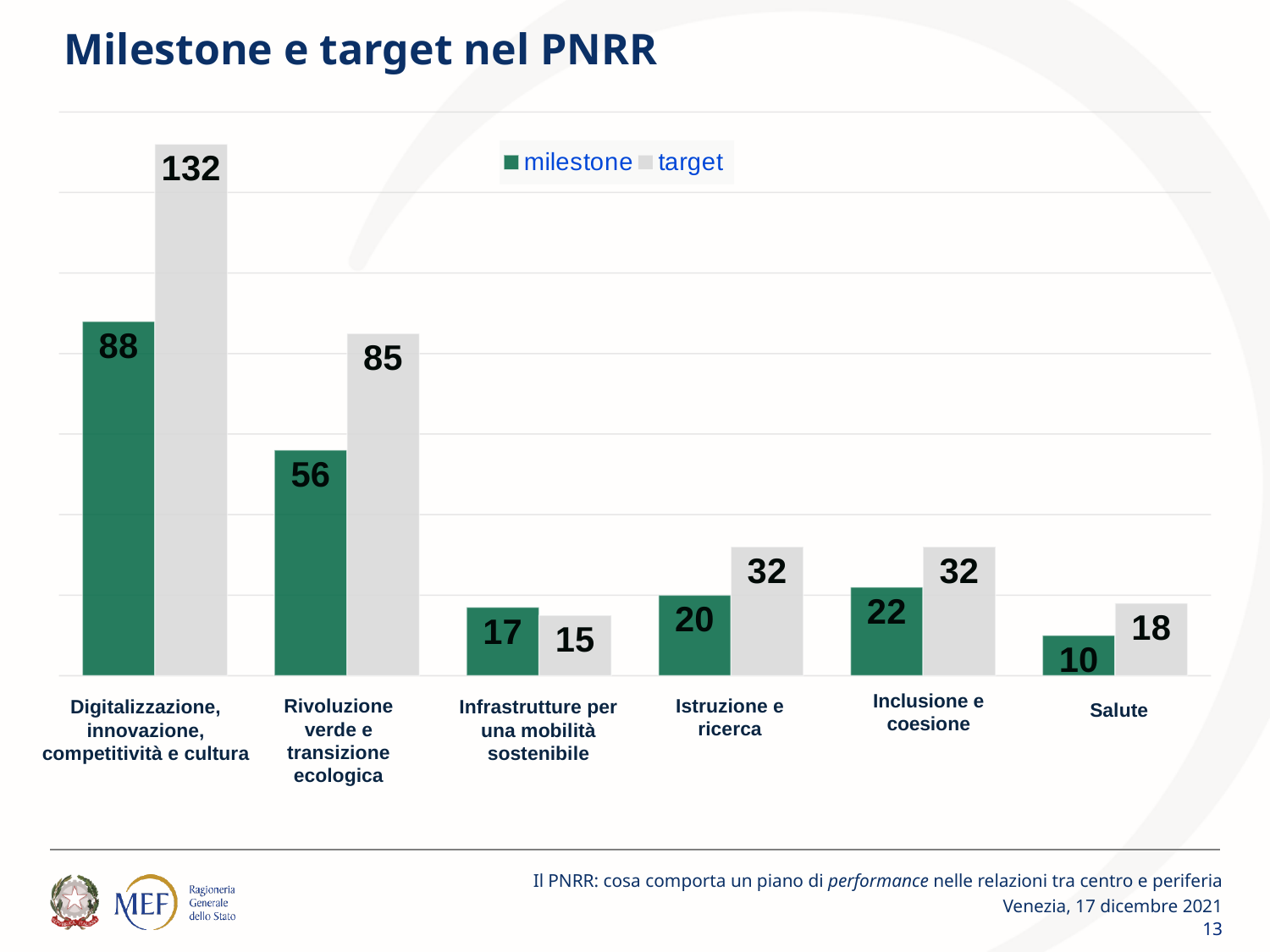
Which is larger for Infrastrutture per una mobilità sostenibile, the milestone value or the target value? milestone What is the target value for Istruzione e ricerca? 32 What is the milestone value for Digitalizzazione, innovazione, competitività e cultura? 88 How many series does the legend list? 2 How many categories are shown on the x axis? 6 What is the difference between the target and milestone values for Digitalizzazione, innovazione, competitività e cultura? 44 What is the target value for Rivoluzione verde e transizione ecologica? 85 Which category has the highest target value? Digitalizzazione, innovazione, competitività e cultura What kind of chart is shown on the slide? bar chart What is the milestone value for Salute? 10 Which category has the lowest milestone value? Salute What colour are the milestone bars? green